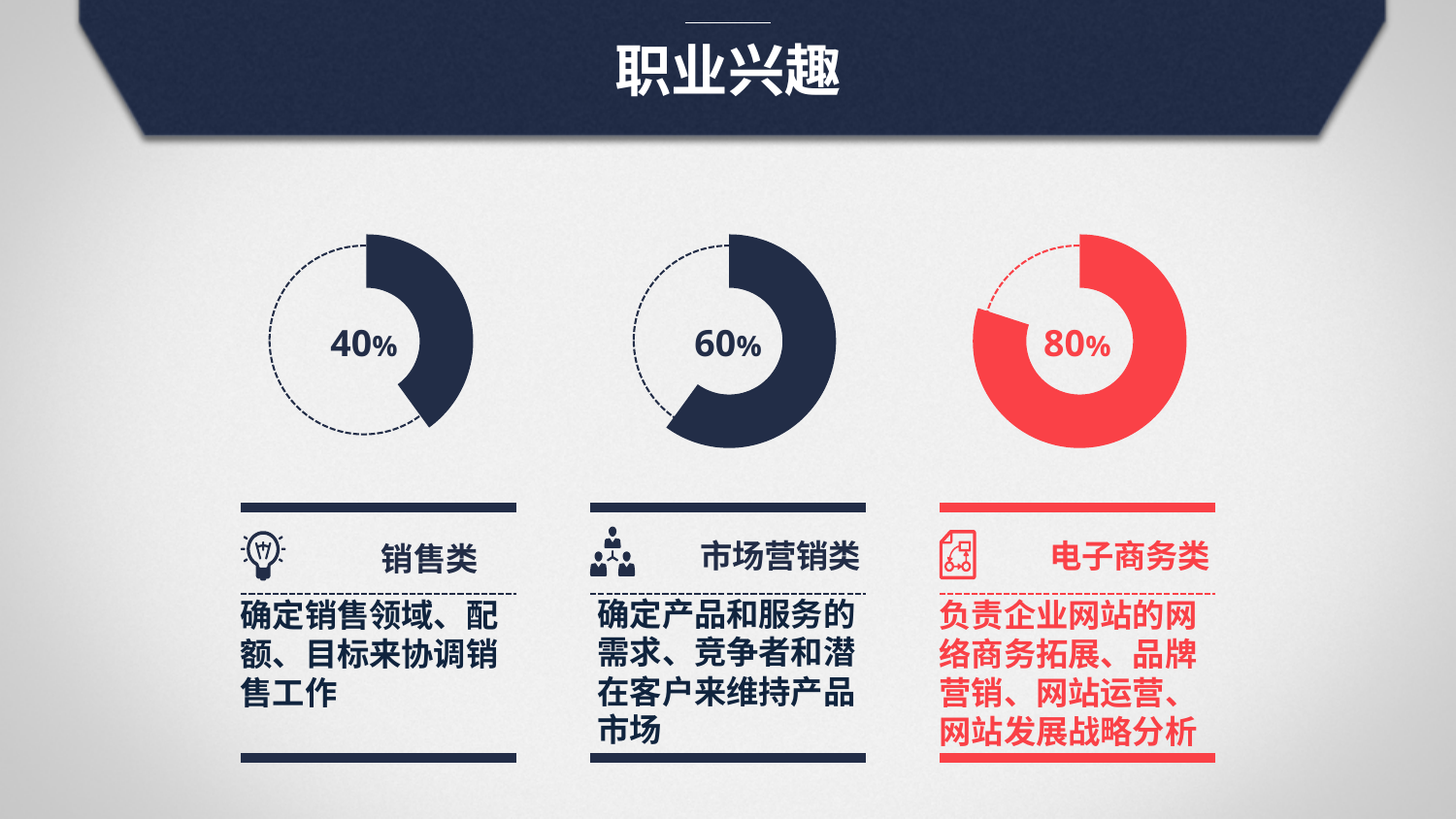
What percentage is shown in the donut chart for 市场营销类? 60% What is the title of the slide containing the three donut charts? 职业兴趣 Which category has the highest percentage among the three donut charts? 电子商务类 What percentage is shown in the donut chart for 销售类? 40% Which donut chart is drawn in red rather than dark navy? 电子商务类 Which category has the lowest percentage among the three donut charts? 销售类 What kind of chart is used to show each percentage on the slide? Donut chart What is the difference between the percentage for 电子商务类 and the percentage for 销售类? 40% What is the difference between the percentage for 市场营销类 and the percentage for 销售类? 20% What percentage is shown in the donut chart for 电子商务类? 80% How many donut charts are shown on the slide? 3 Which is larger, the percentage for 市场营销类 or the percentage for 销售类? 市场营销类